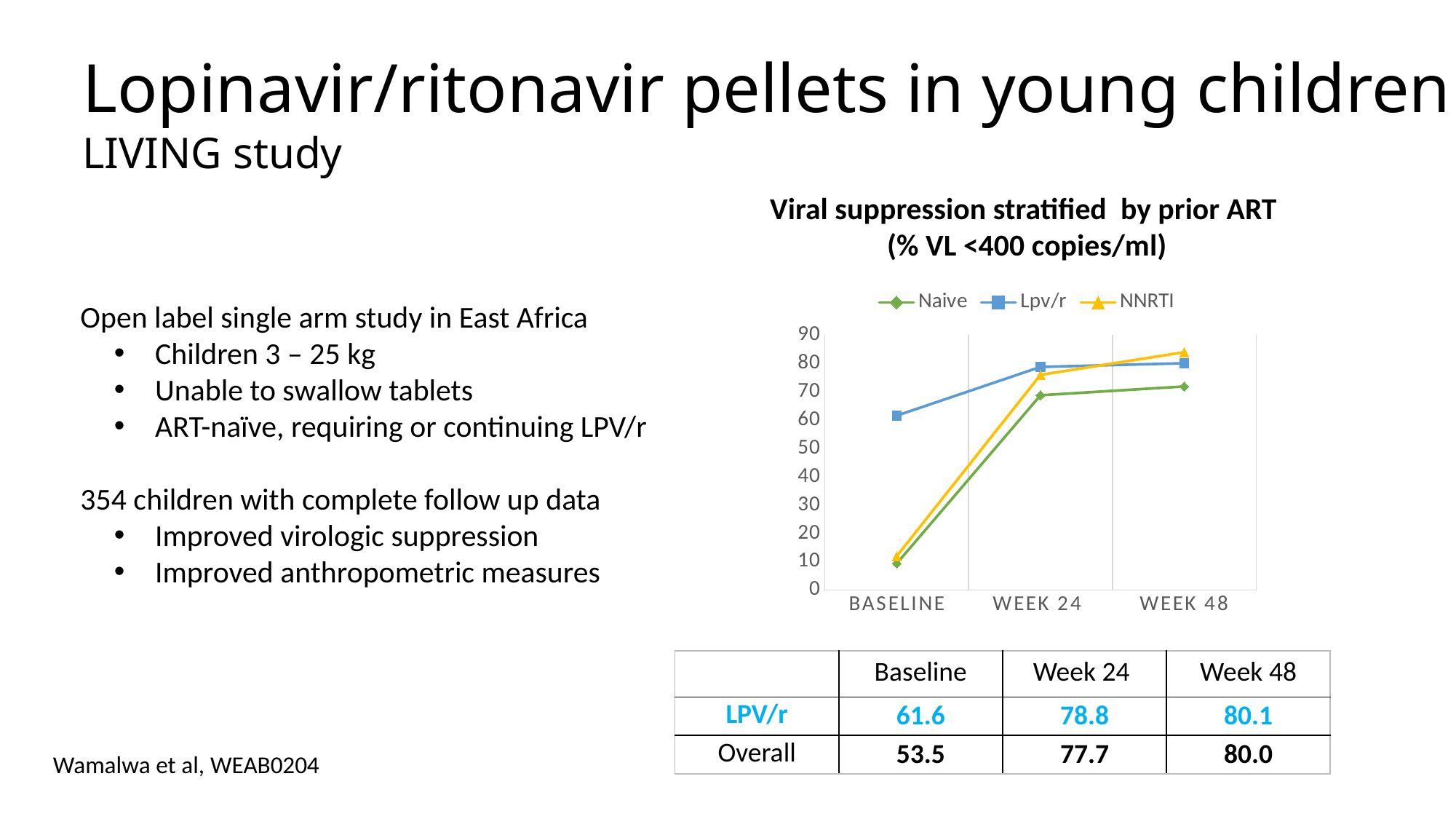
Which series has the highest value at Baseline? Lpv/r Is the value for Naive at Baseline greater or less than 20? less Is the value for NNRTI at Week 48 greater or less than 80? greater What kind of chart is shown on the slide? line chart Which series has the lowest value at Week 48? Naive What is the title of the chart? Viral suppression stratified by prior ART (% VL <400 copies/ml) At Week 48, which is larger: the NNRTI value or the Naive value? NNRTI How many time points are plotted along the x axis of the chart? 3 Is the value for Lpv/r at Baseline greater or less than 50? greater How many series does the chart legend list? 3 Does the Naive series rise or fall from Baseline to Week 48? rise